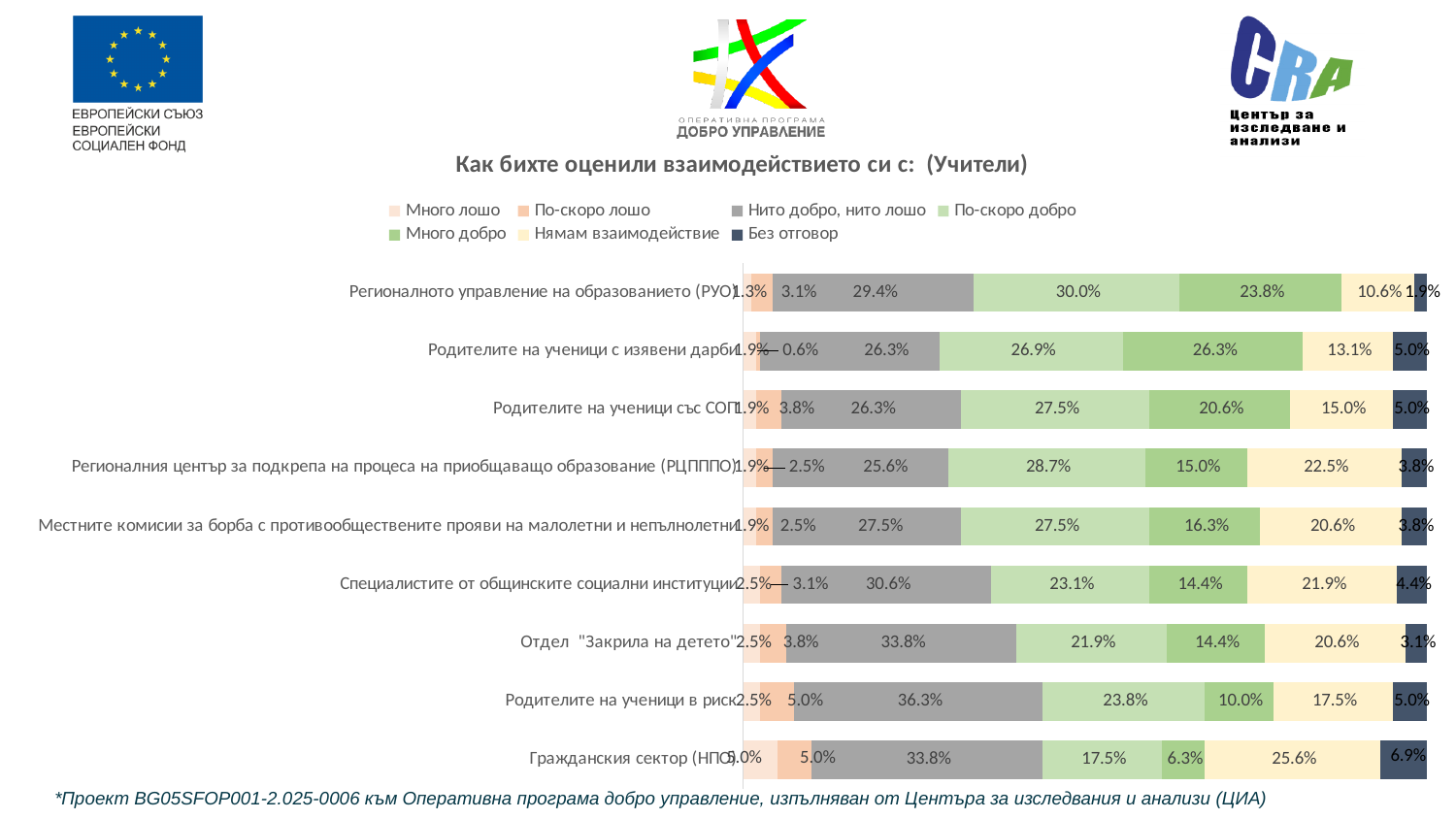
Which has the larger "Нито добро, нито лошо" value: "Отдел "Закрила на детето"" or "Специалистите от общинските социални институции"? Отдел "Закрила на детето" What is the difference between the "Много добро" values for "Регионалното управление на образованието (РУО)" and "Родителите на ученици в риск"? 13.8 percentage points What is the value of "Нито добро, нито лошо" for "Родителите на ученици в риск"? 36.3% Which category has the highest value for "Нямам взаимодействие"? Гражданския сектор (НПО) What is the value of "Без отговор" for "Гражданския сектор (НПО)"? 6.9% What is the title of the chart? Как бихте оценили взаимодействието си с: (Учители) How many series does the legend list? 7 How many categories (bars) are shown in the chart? 9 Which category has the highest value for "Нито добро, нито лошо"? Родителите на ученици в риск What kind of chart is shown on the slide? Stacked bar chart Which category has the lowest value for "Много добро"? Гражданския сектор (НПО) What is the value of "По-скоро добро" for "Регионалното управление на образованието (РУО)"? 30.0%